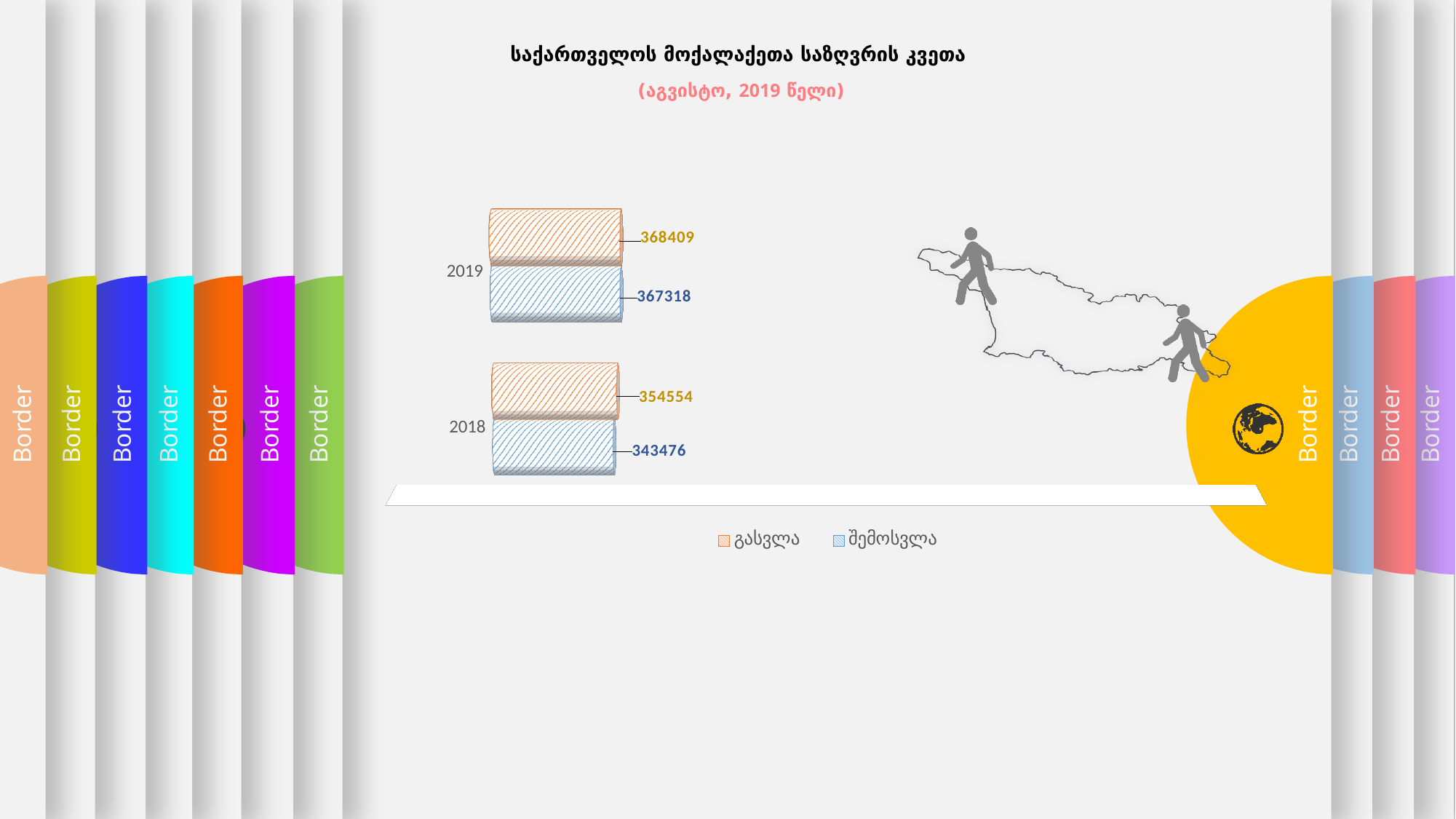
What is the value of გასვლა for 2018? 354554 How many series does the legend list? 2 By how much did გასვლა increase from 2018 to 2019? 13855 What is the difference between გასვლა and შემოსვლა in 2018? 11078 Which is larger in 2019, გასვლა or შემოსვლა? გასვლა What is the value of შემოსვლა for 2018? 343476 How many years are shown on the chart? 2 What is the value of შემოსვლა for 2019? 367318 What kind of chart is shown on the slide? bar chart What is the value of გასვლა for 2019? 368409 Which year has the lower value for გასვლა? 2018 Which year has the higher value for შემოსვლა? 2019